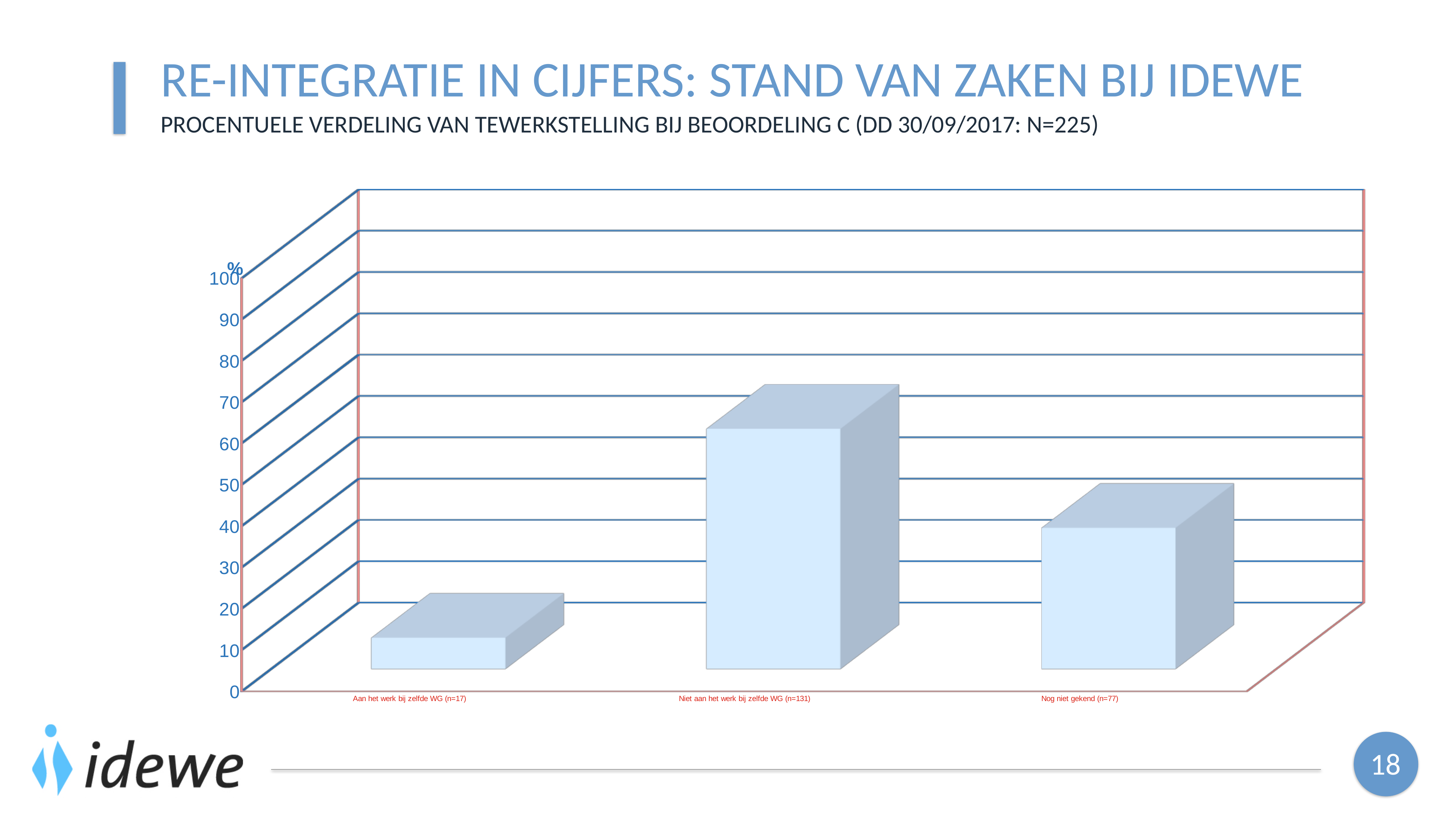
Is the value for Nog niet gekend (n=77) greater or less than 20? greater Is the value for Aan het werk bij zelfde WG (n=17) greater or less than 20? less Which category has the highest bar? Niet aan het werk bij zelfde WG (n=131) Which is larger: the bar for Nog niet gekend (n=77) or the bar for Aan het werk bij zelfde WG (n=17)? Nog niet gekend (n=77) Is the value for Nog niet gekend (n=77) greater or less than 50? less What unit is shown at the top of the vertical axis? % What is the highest tick value shown on the vertical axis? 100 Which is larger: the bar for Niet aan het werk bij zelfde WG (n=131) or the bar for Nog niet gekend (n=77)? Niet aan het werk bij zelfde WG (n=131) Which category has the lowest bar? Aan het werk bij zelfde WG (n=17) How many categories are plotted on the chart? 3 What kind of chart is shown on the slide? bar chart